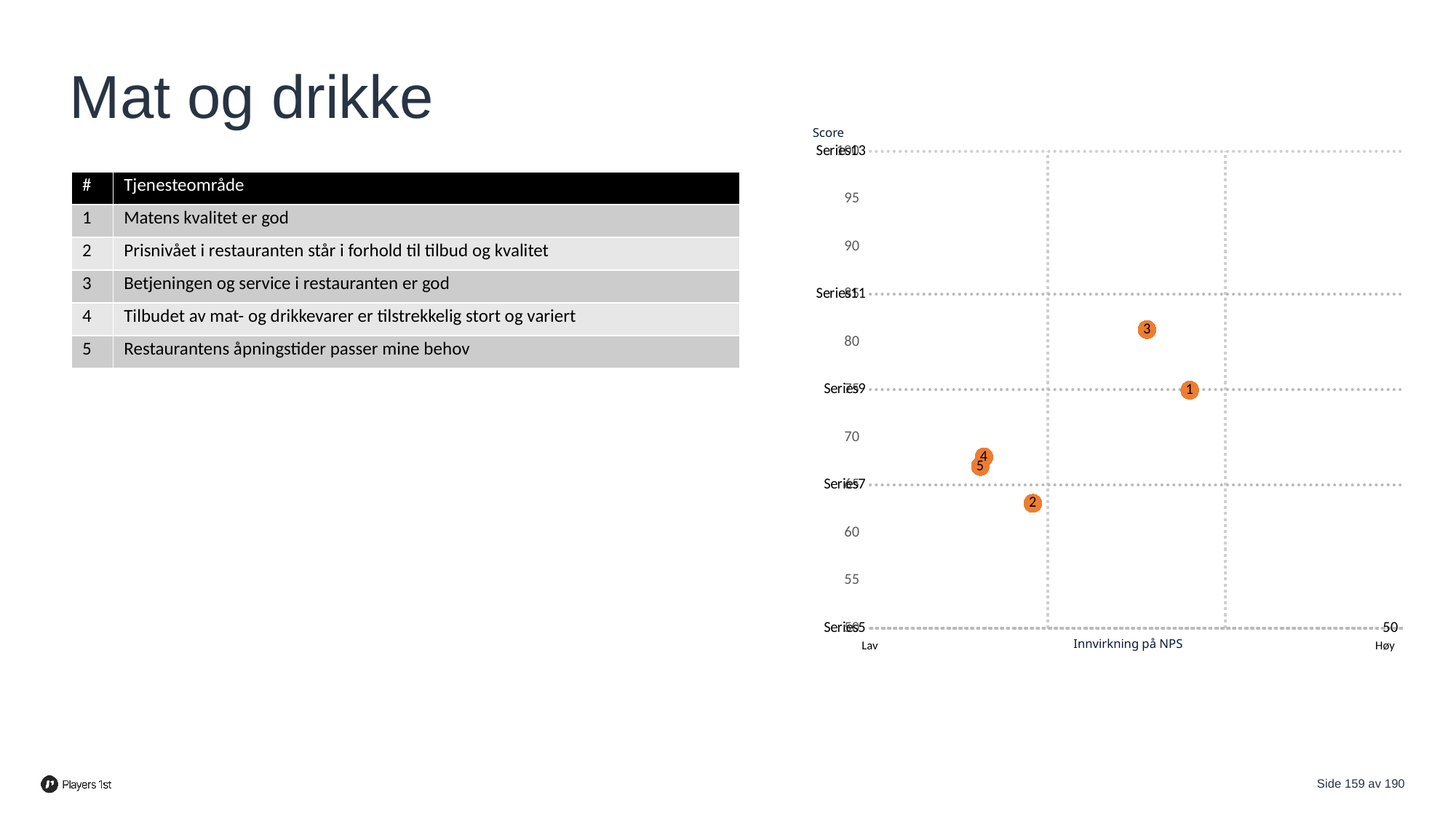
What kind of chart is shown on the slide? scatter chart What is the title of the horizontal axis of the chart? Innvirkning på NPS How many data points are plotted in the chart? 5 Which point lies furthest to the right (highest Innvirkning på NPS)? 1 Which has a higher score, point 1 or point 2? 1 Which point has the highest score in the chart? 3 Is the score for point 2 greater or less than 70? less Which point has the lowest score in the chart? 2 Which has a higher score, point 3 or point 1? 3 Is the score for point 3 greater or less than 75? greater Is the score for point 4 greater or less than 70? less